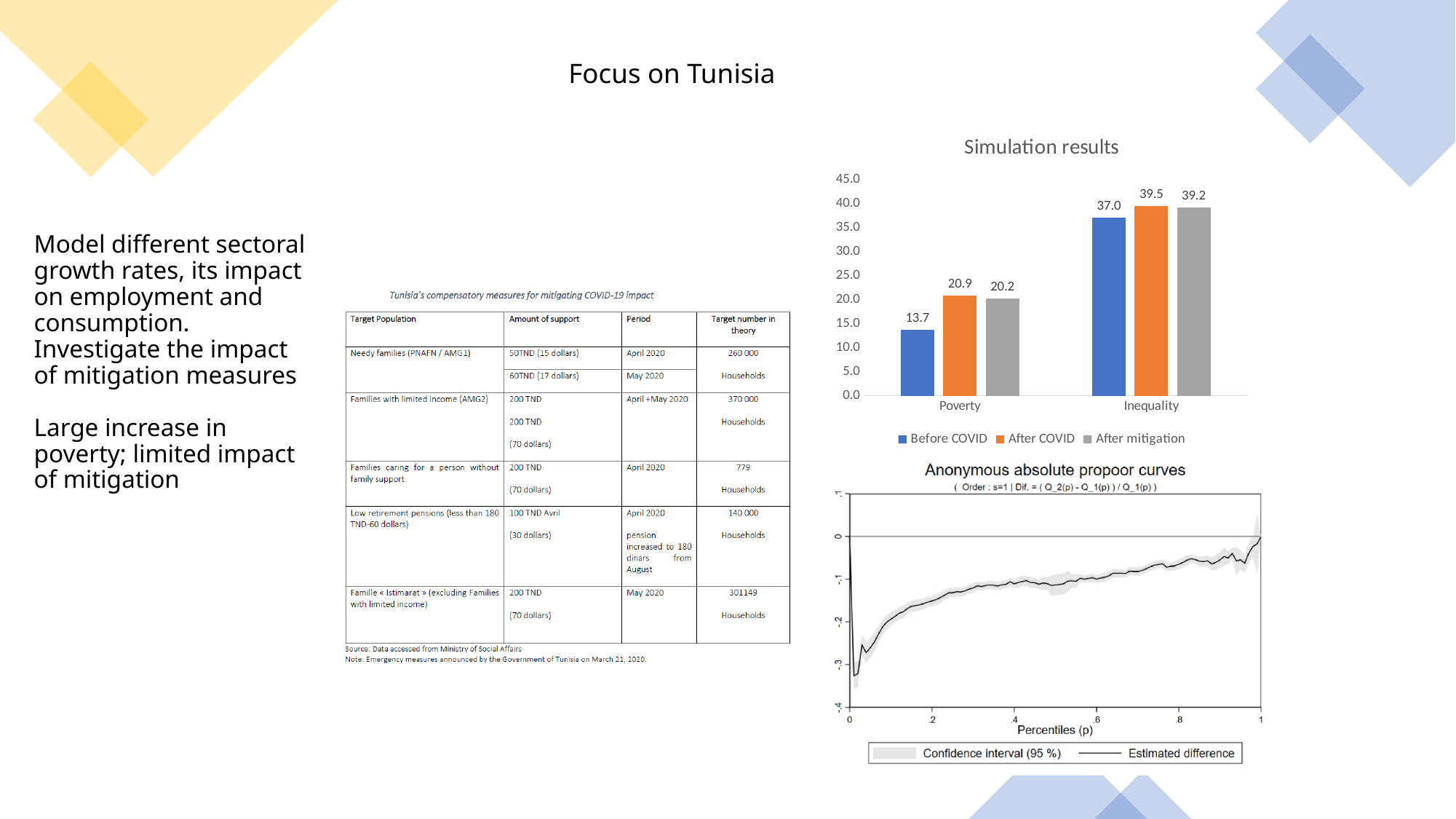
In the Simulation results chart, what is the After COVID value for Inequality? 39.5 In the Simulation results chart, which series has the lowest value for Inequality? Before COVID In the Simulation results chart, how many series does the legend list? 3 What kind of chart is the Simulation results chart? bar chart In the Simulation results chart, which series has the highest value for Poverty? After COVID In the Simulation results chart, what is the difference between the After COVID and Before COVID values for Poverty? 7.2 In the Anonymous absolute propoor curves chart, how many entries does the legend list? 2 In the Anonymous absolute propoor curves chart, does the Estimated difference line generally rise or fall as the percentile increases from 0.2 to 1? rise In the Simulation results chart, how many categories are shown on the x axis? 2 In the Simulation results chart, what is the After mitigation value for Poverty? 20.2 In the Simulation results chart, what is the Before COVID value for Poverty? 13.7 In the Simulation results chart, what is the difference between the After COVID and After mitigation values for Inequality? 0.3